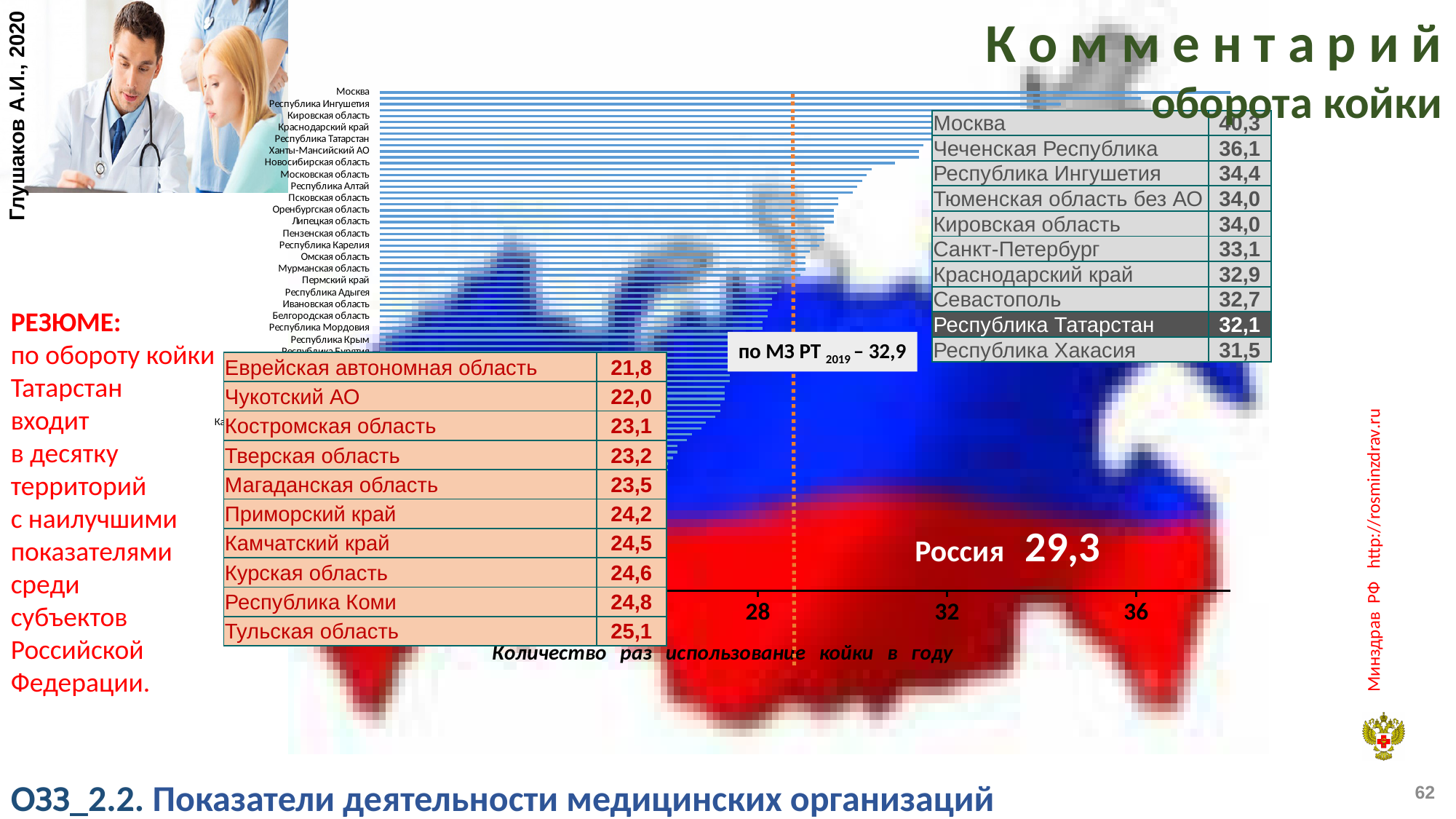
What is the value for Еврейская автономная область in the lower table? 21,8 How many regions are listed in the top table of best values? 10 What is the x-axis label of the chart? Количество раз использование койки в году Which region is listed first (at the top) of the bar chart? Москва What is the difference between the values for Москва (40,3) and Республика Татарстан (32,1)? 8,2 What is the bed turnover value for Москва in the top table? 40,3 What is the bed turnover value for Республика Татарстан? 32,1 What is the value shown for Россия on the chart? 29,3 What kind of chart is shown on the slide? bar chart Which region has the highest bed turnover value in the top table? Москва Which has the larger value: Кировская область or Санкт-Петербург? Кировская область Which region has the lowest bed turnover value in the lower table? Еврейская автономная область